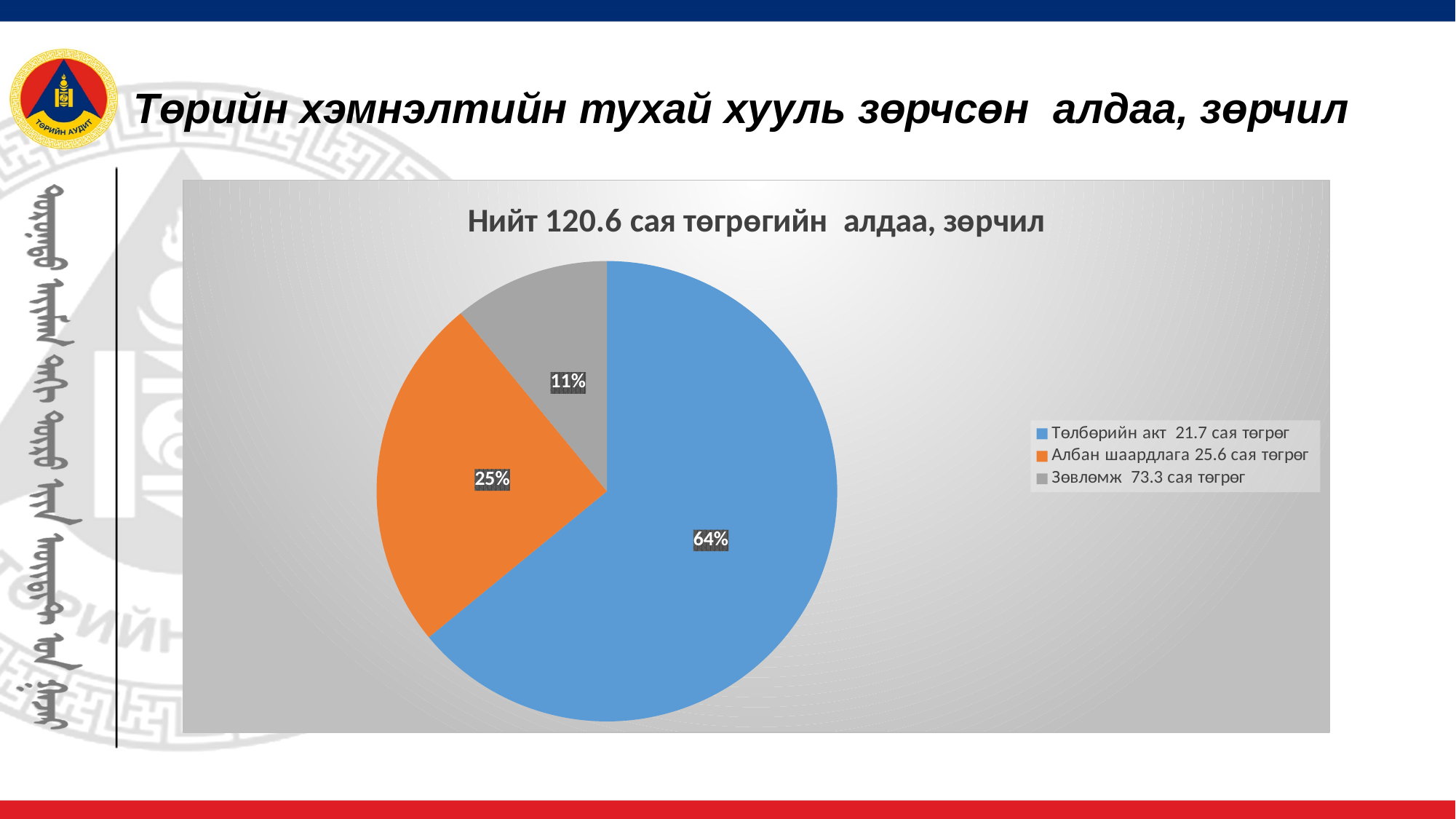
What is the title of the chart? Нийт 120.6 сая төгрөгийн алдаа, зөрчил What percentage is shown for the Зөвлөмж slice? 11% What is the difference in percentage points between the Төлбөрийн акт slice and the Албан шаардлага slice? 39 percentage points What percentage is shown for the Төлбөрийн акт slice? 64% What colour is the Албан шаардлага slice? Orange Which category has the smallest share of the pie? Зөвлөмж Which slice is larger, Албан шаардлага or Зөвлөмж? Албан шаардлага What kind of chart is shown on the slide? Pie chart How many slices does the pie chart have? 3 What percentage is shown for the Албан шаардлага slice? 25% What amount does the legend give for Зөвлөмж? 73.3 сая төгрөг Which category has the largest share of the pie? Төлбөрийн акт